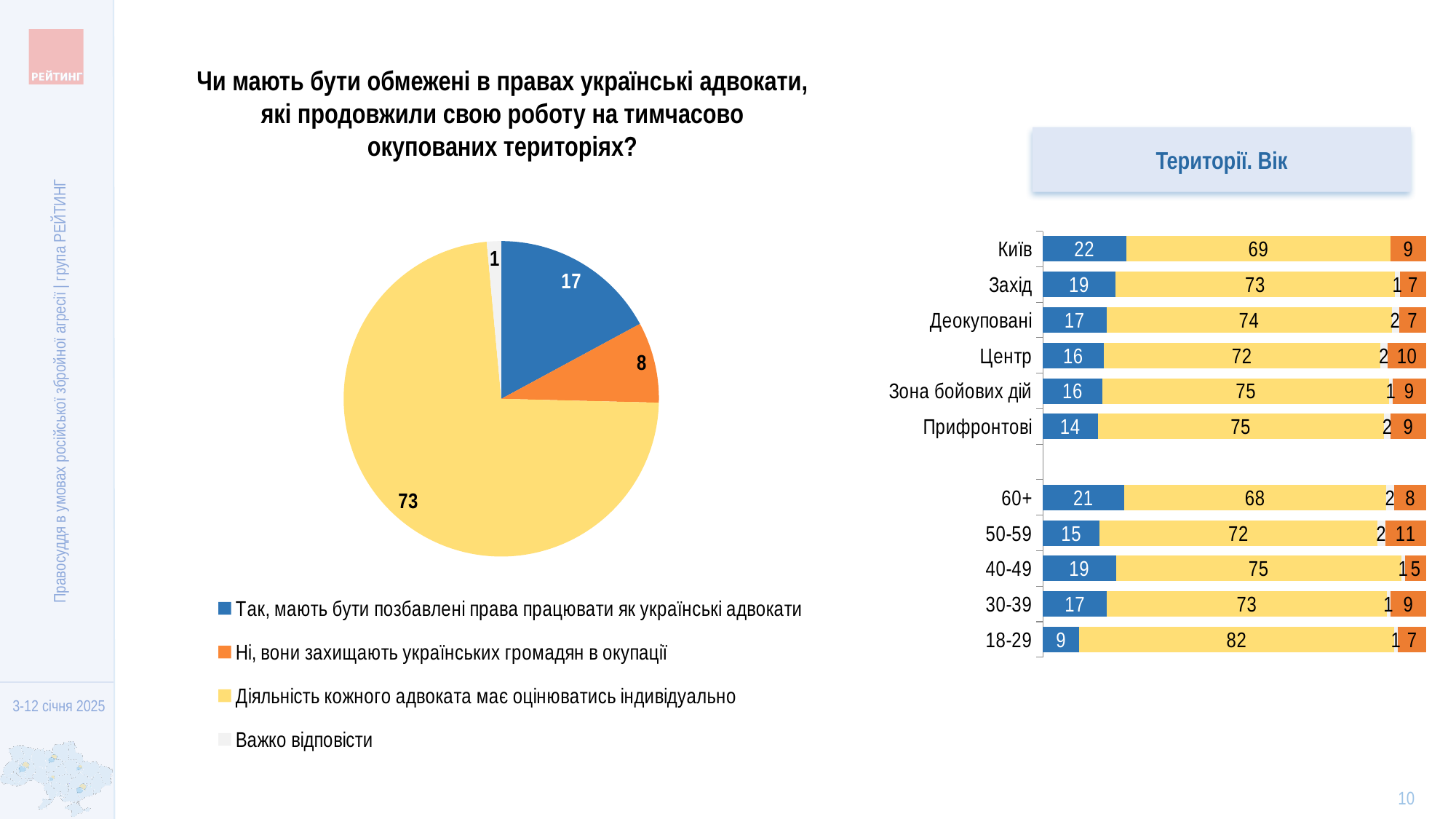
In the pie chart, what value is shown for "Ні, вони захищають українських громадян в окупації"? 8 What type of chart is shown on the right side of the slide under "Території. Вік"? Stacked bar chart How many entries does the legend of the pie chart list? 4 In the pie chart, what is the difference between the "Так" slice and the "Ні" slice? 9 In the "Території. Вік" bar chart, which category has the largest blue segment? Київ In the "Території. Вік" bar chart, which category has the smallest blue segment? 18-29 In the "Території. Вік" bar chart, what is the value of the blue segment for Київ? 22 How many categories (rows) are shown in the "Території. Вік" bar chart? 11 In the "Території. Вік" bar chart, what is the value of the yellow segment for the 18-29 age group? 82 In the "Території. Вік" bar chart, is the orange segment larger for 50-59 or for 40-49? 50-59 In the pie chart, which answer option has the smallest share? Важко відповісти In the pie chart, what percentage of respondents chose "Діяльність кожного адвоката має оцінюватись індивідуально"? 73